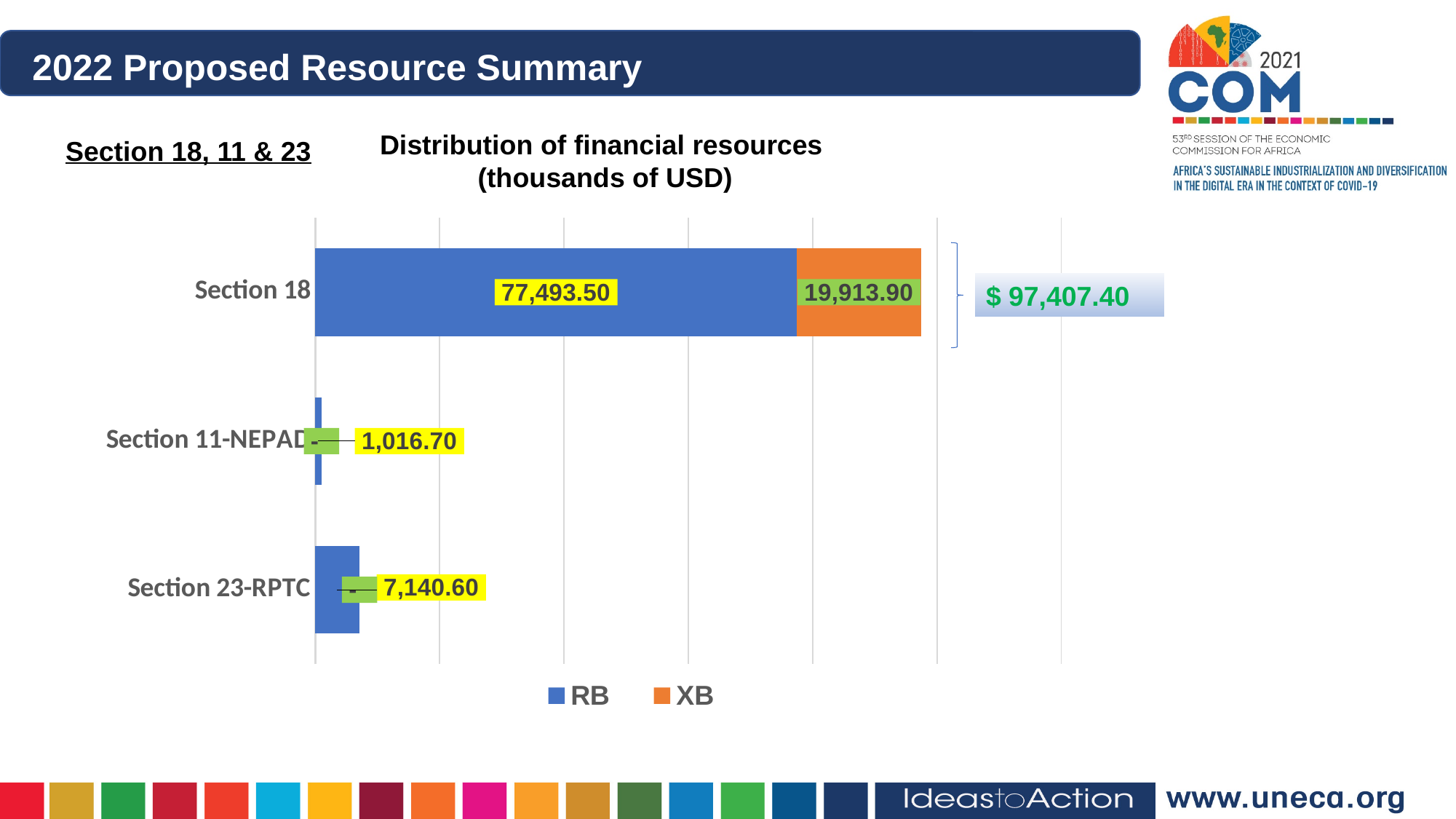
Which is larger, the RB value for Section 23-RPTC or the RB value for Section 11-NEPAD? Section 23-RPTC Which section has the highest RB value? Section 18 How many sections are shown in the chart? 3 What type of chart is shown on the slide? Bar chart What is the RB value for Section 23-RPTC? 7,140.60 What is the difference between the RB and XB values for Section 18? 57,579.60 Which section has the lowest RB value? Section 11-NEPAD What is the RB value for Section 18? 77,493.50 What is the total of the stacked bar for Section 18? $ 97,407.40 What is the XB value for Section 18? 19,913.90 How many series does the legend list? 2 What is the RB value for Section 11-NEPAD? 1,016.70